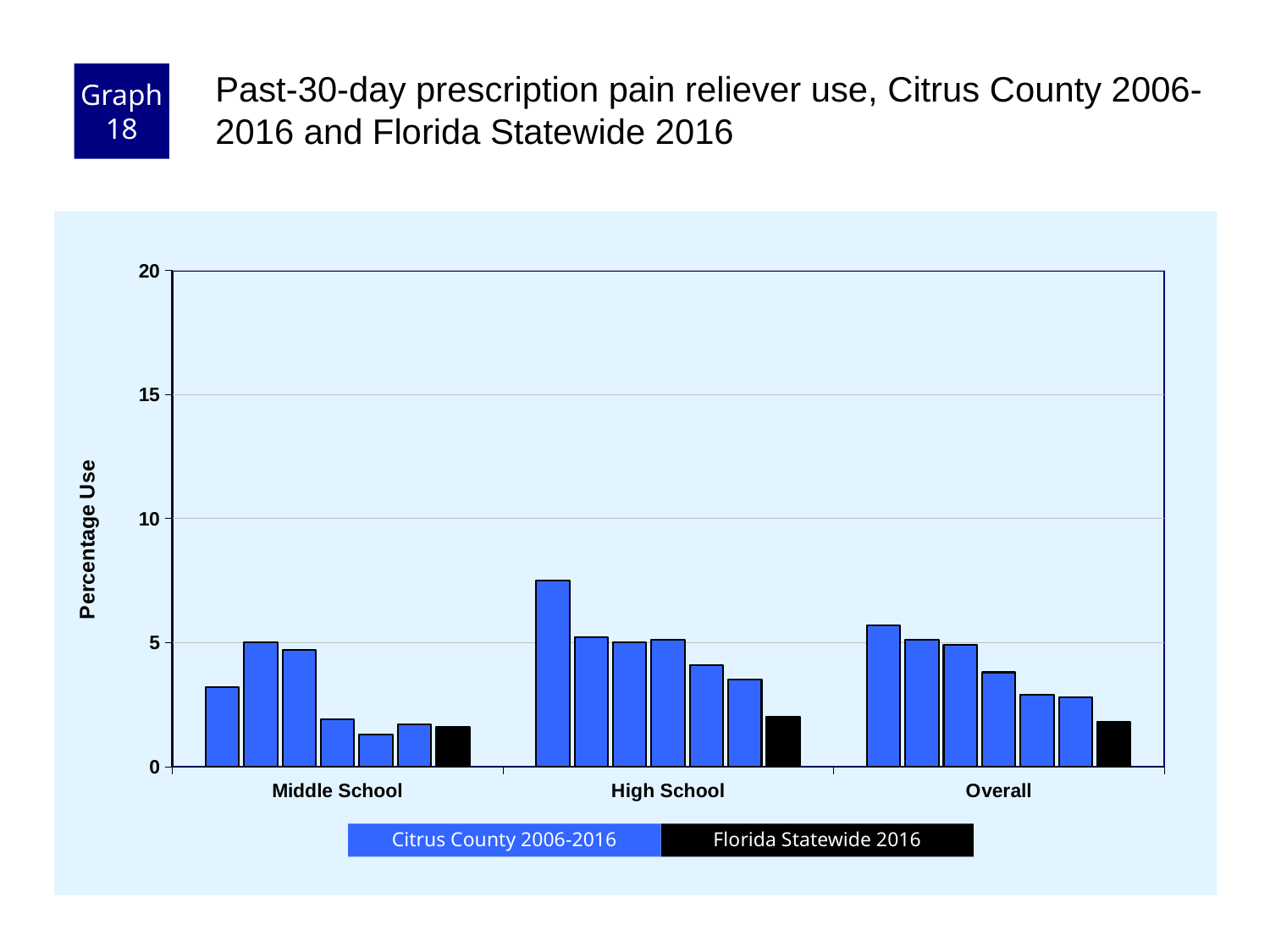
Is the tallest Citrus County 2006-2016 bar for Overall greater or less than 10? less How many school-level categories are shown on the x axis? 3 Is the Florida Statewide 2016 value for Middle School greater or less than 5? less Is the Florida Statewide 2016 value for High School greater or less than 5? less What is the label on the y axis? Percentage Use Within the Overall category, do the Citrus County 2006-2016 bars generally rise or fall from left to right? fall Which is larger: the tallest Citrus County 2006-2016 bar for High School or the tallest Citrus County 2006-2016 bar for Middle School? High School Which colour represents Florida Statewide 2016 in the legend? black What kind of chart is shown on the slide? bar chart How many series does the legend list? 2 Which category contains the tallest bar in the chart? High School